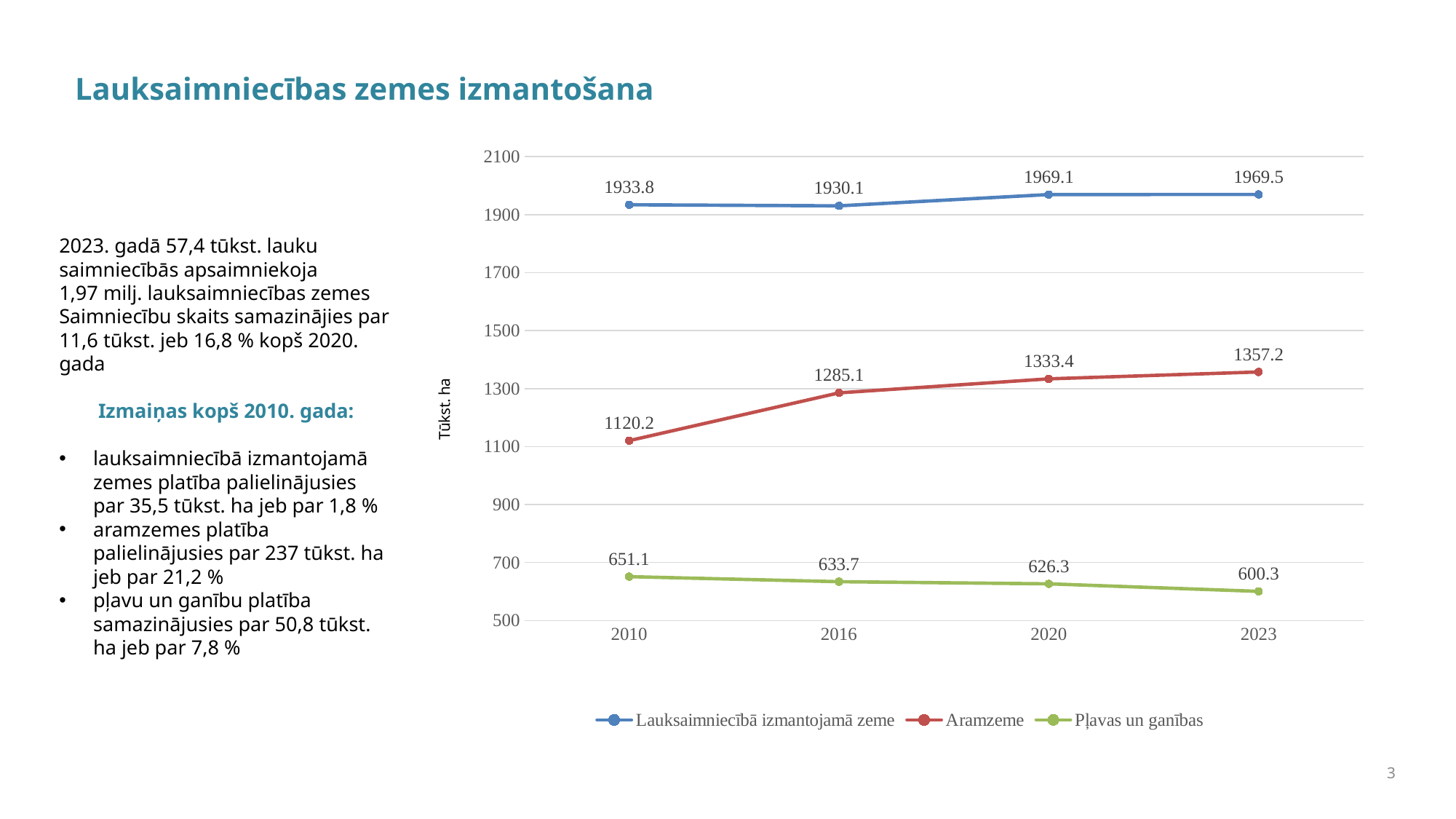
How many years are shown on the x axis? 4 In which year is the Aramzeme series lowest? 2010 Which is larger: Pļavas un ganības in 2016 or in 2020? 2016 What is the difference between the Aramzeme values in 2023 and 2010? 237 What is the value for Lauksaimniecībā izmantojamā zeme in 2016? 1930.1 What kind of chart is shown? line chart Does the Pļavas un ganības series rise or fall from 2010 to 2023? fall What is the value for Aramzeme in 2023? 1357.2 Is the value for Aramzeme in 2016 greater or less than 1300? less What is the value for Pļavas un ganības in 2010? 651.1 In which year is the Pļavas un ganības series lowest? 2023 How many series does the legend list? 3